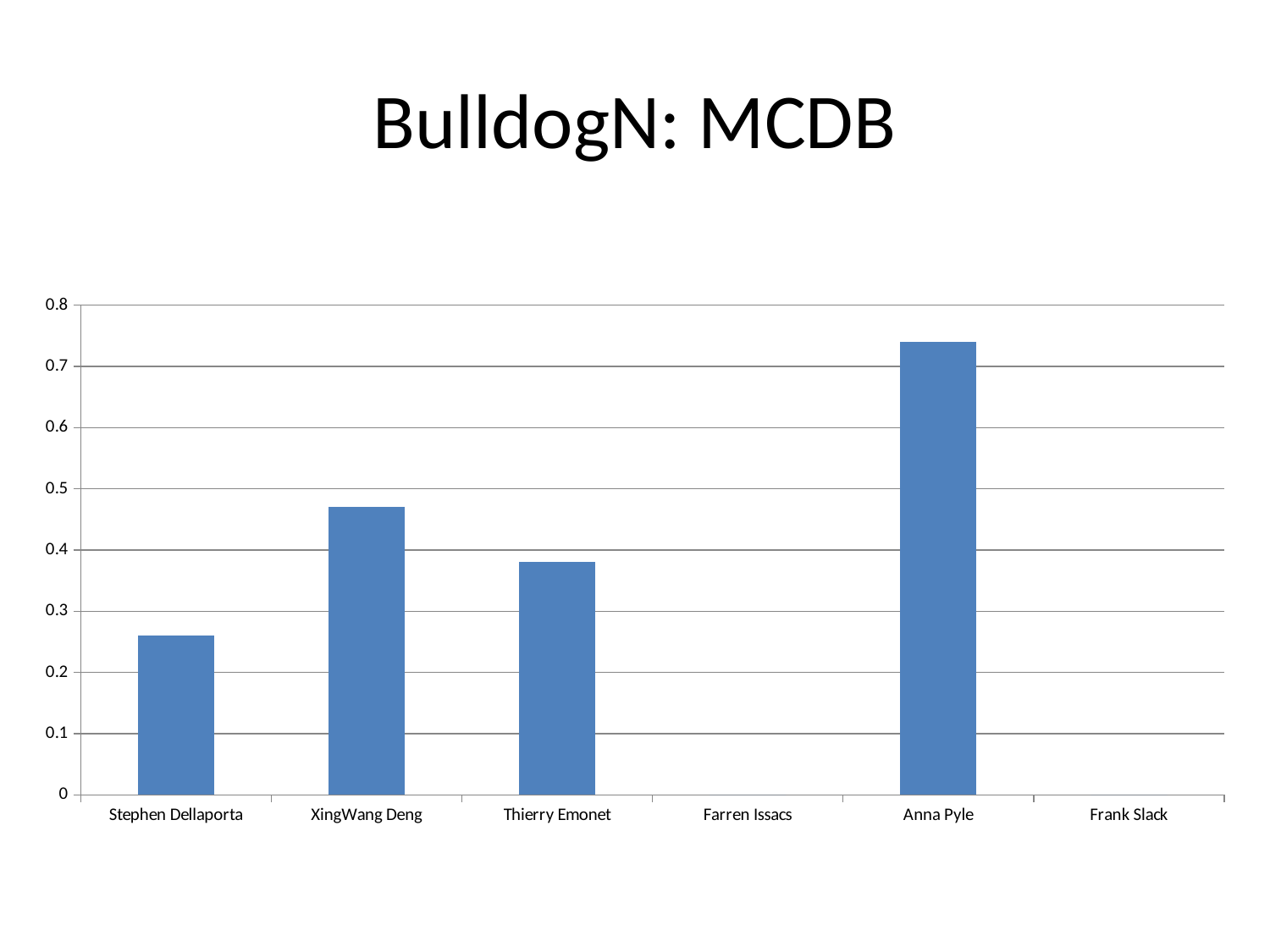
Is the value for Anna Pyle greater or less than 0.7? greater What kind of chart is shown on the slide? bar chart Is the value for XingWang Deng greater or less than 0.4? greater Is the value for Stephen Dellaporta greater or less than 0.3? less How many categories are shown on the x axis of the chart? 6 Which category has the highest value in the chart? Anna Pyle Which is larger, the value for XingWang Deng or the value for Thierry Emonet? XingWang Deng What is the title of the slide containing the chart? BulldogN: MCDB What is the highest value shown on the y axis of the chart? 0.8 Which is larger, the value for Stephen Dellaporta or the value for Anna Pyle? Anna Pyle